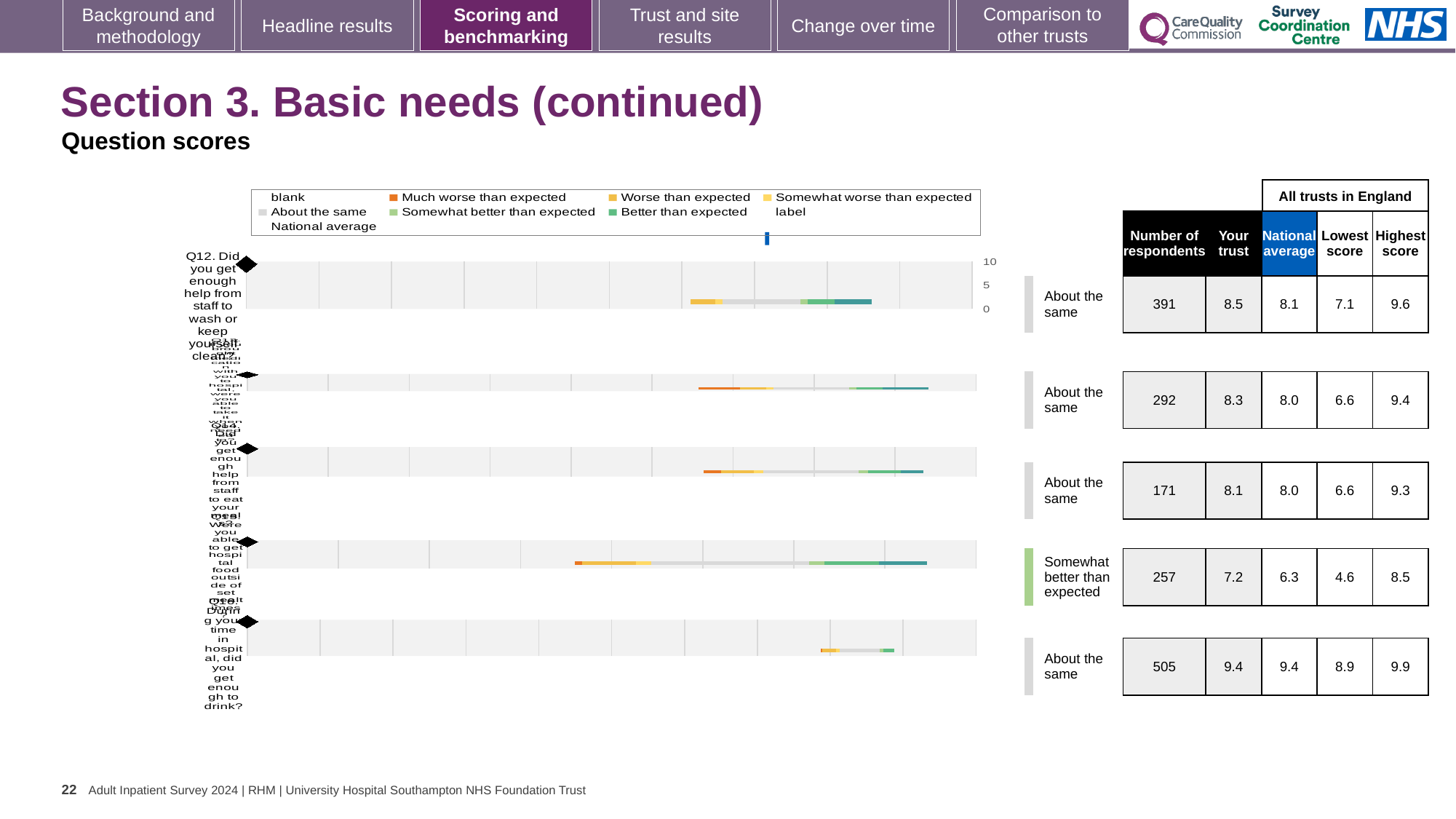
What is the lowest 'Your trust' score shown on the slide? 7.2 How many respondents answered Q16 (During your time in hospital, did you get enough to drink?)? 505 What is the highest score among all trusts in England for Q16? 9.9 What is the difference between the 'Your trust' score and the national average for Q12? 0.4 What colour does the legend use for 'Much worse than expected'? Orange Which row is rated 'Somewhat better than expected' rather than 'About the same'? The fourth row (Q15) Which question row has the highest 'Your trust' score? Q16 What is the national average score for Q12? 8.1 What is the lowest score among all trusts in England for Q14? 6.6 Which is larger: the 'Your trust' score for Q12 or for Q14 (help from staff to eat your meals)? Q12 How many survey questions are plotted as rows in the chart? 5 What is the 'Your trust' score for Q12 (Did you get enough help from staff to wash or keep yourself clean?)? 8.5